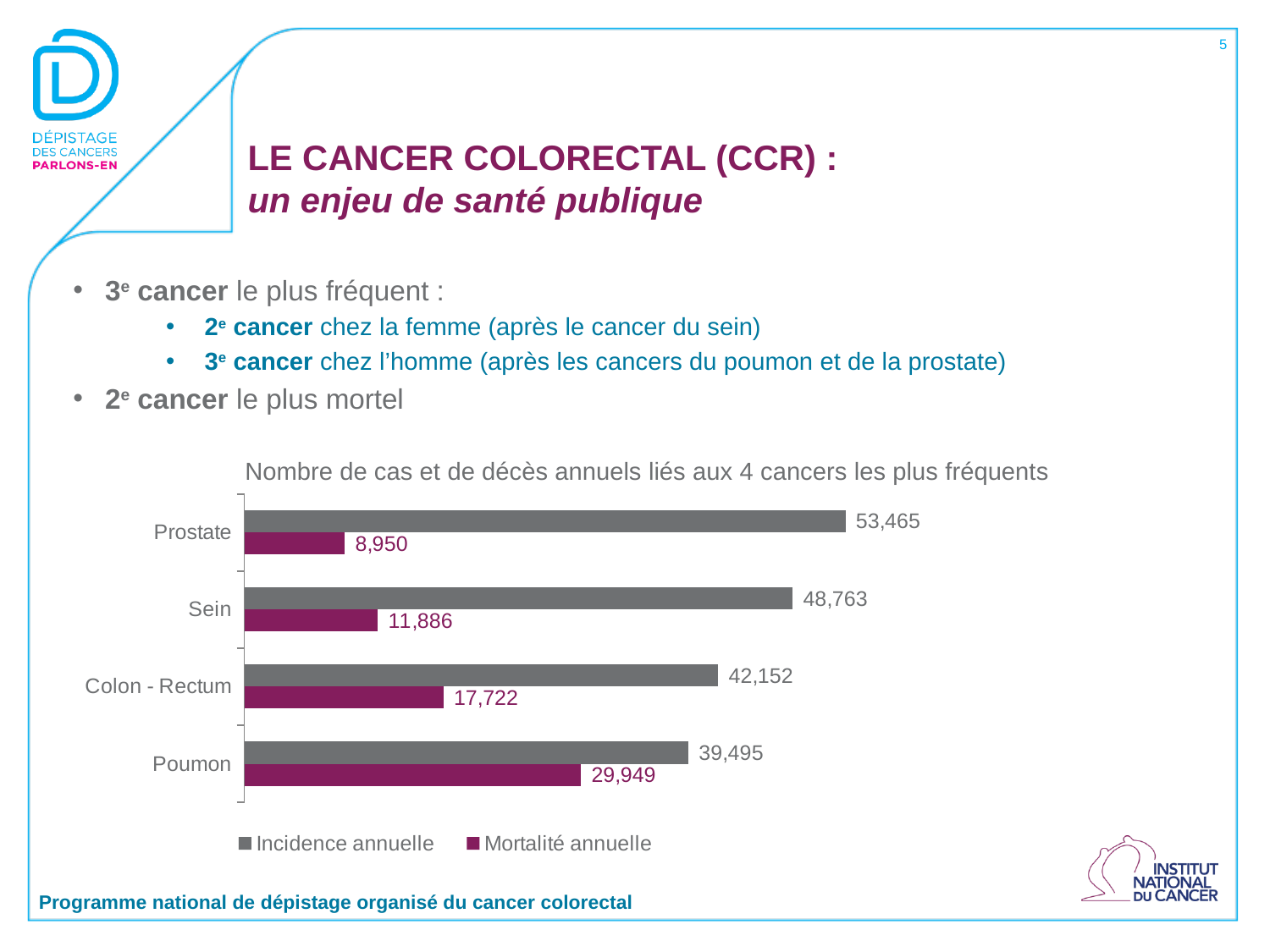
How many series does the chart legend list? 2 How many cancer categories are shown in the chart? 4 Which cancer has the highest annual mortality (Mortalité annuelle)? Poumon Which cancer has the lowest annual mortality (Mortalité annuelle)? Prostate What is the difference between annual incidence and annual mortality for Colon - Rectum? 24,430 What is the annual incidence (Incidence annuelle) for Prostate? 53,465 What is the annual mortality (Mortalité annuelle) for Poumon? 29,949 What type of chart is shown on the slide? Bar chart What is the annual mortality (Mortalité annuelle) for Colon - Rectum? 17,722 What is the annual incidence (Incidence annuelle) for Sein? 48,763 Is the annual incidence for Sein larger or smaller than the annual incidence for Colon - Rectum? larger Which cancer has the lowest annual incidence (Incidence annuelle)? Poumon